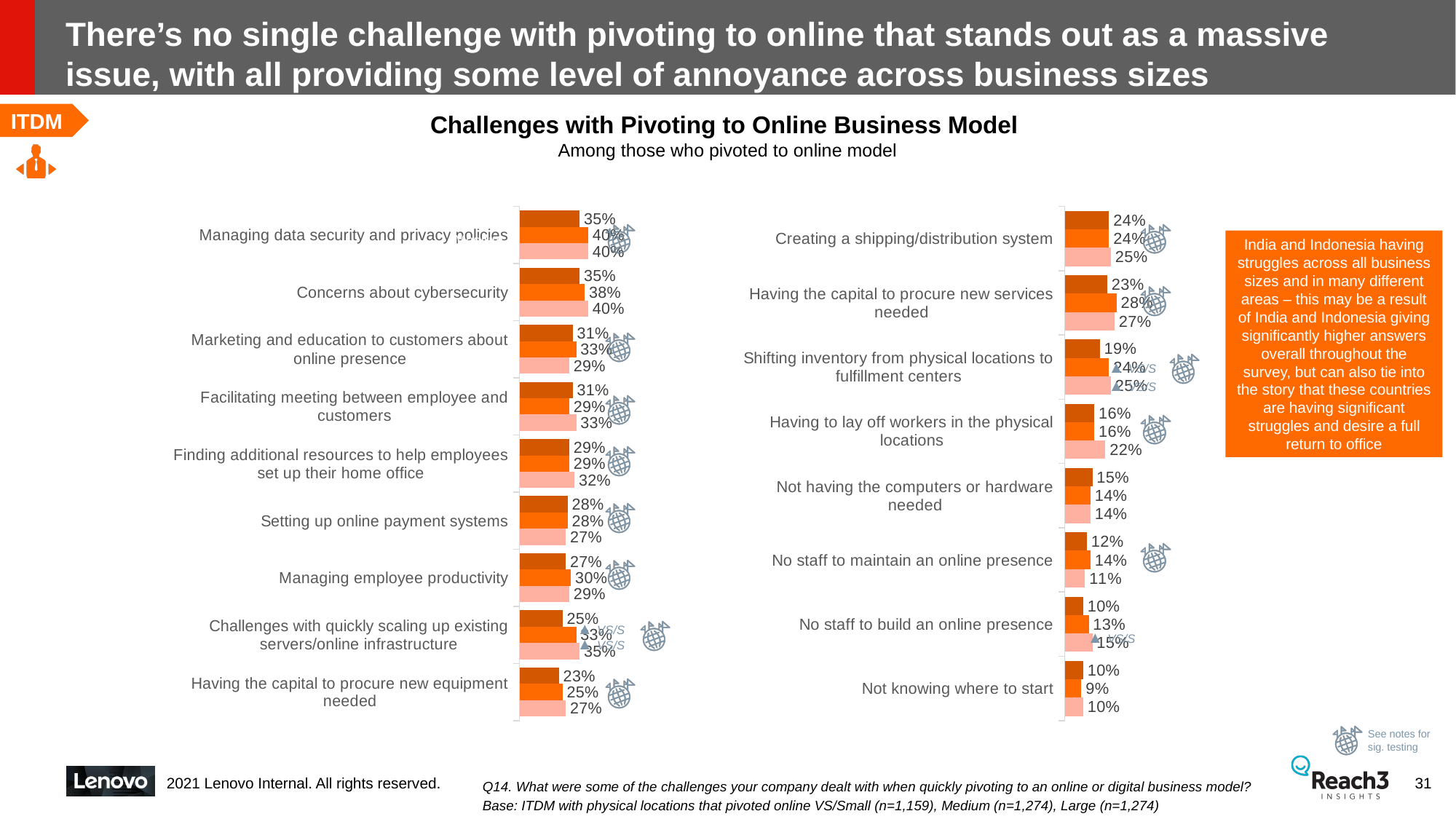
In the right chart, which category has the lowest value for the middle (orange) bar? Not knowing where to start How many categories are shown in the left chart? 9 In the right chart, what is the value of the middle (orange) bar for 'Having the capital to procure new services needed'? 28% In the left chart, which category has the lowest value for the top (dark orange) bar? Having the capital to procure new equipment needed In the left chart, what is the value of the top (dark orange) bar for 'Concerns about cybersecurity'? 35% In the right chart, which is larger for 'Shifting inventory from physical locations to fulfillment centers': the top (dark orange) bar or the bottom (light pink) bar? the bottom (light pink) bar In the right chart, what is the difference between the bottom (light pink) bar and the top (dark orange) bar for 'No staff to build an online presence'? 5% In the right chart, what is the value of the bottom (light pink) bar for 'Having to lay off workers in the physical locations'? 22% How many categories are shown in the right chart? 8 In the left chart, what is the value of the bottom (light pink) bar for 'Challenges with quickly scaling up existing servers/online infrastructure'? 35% In the left chart, what is the difference between the bottom (light pink) bar and the top (dark orange) bar for 'Managing data security and privacy policies'? 5% What type of chart is used on this slide? bar chart